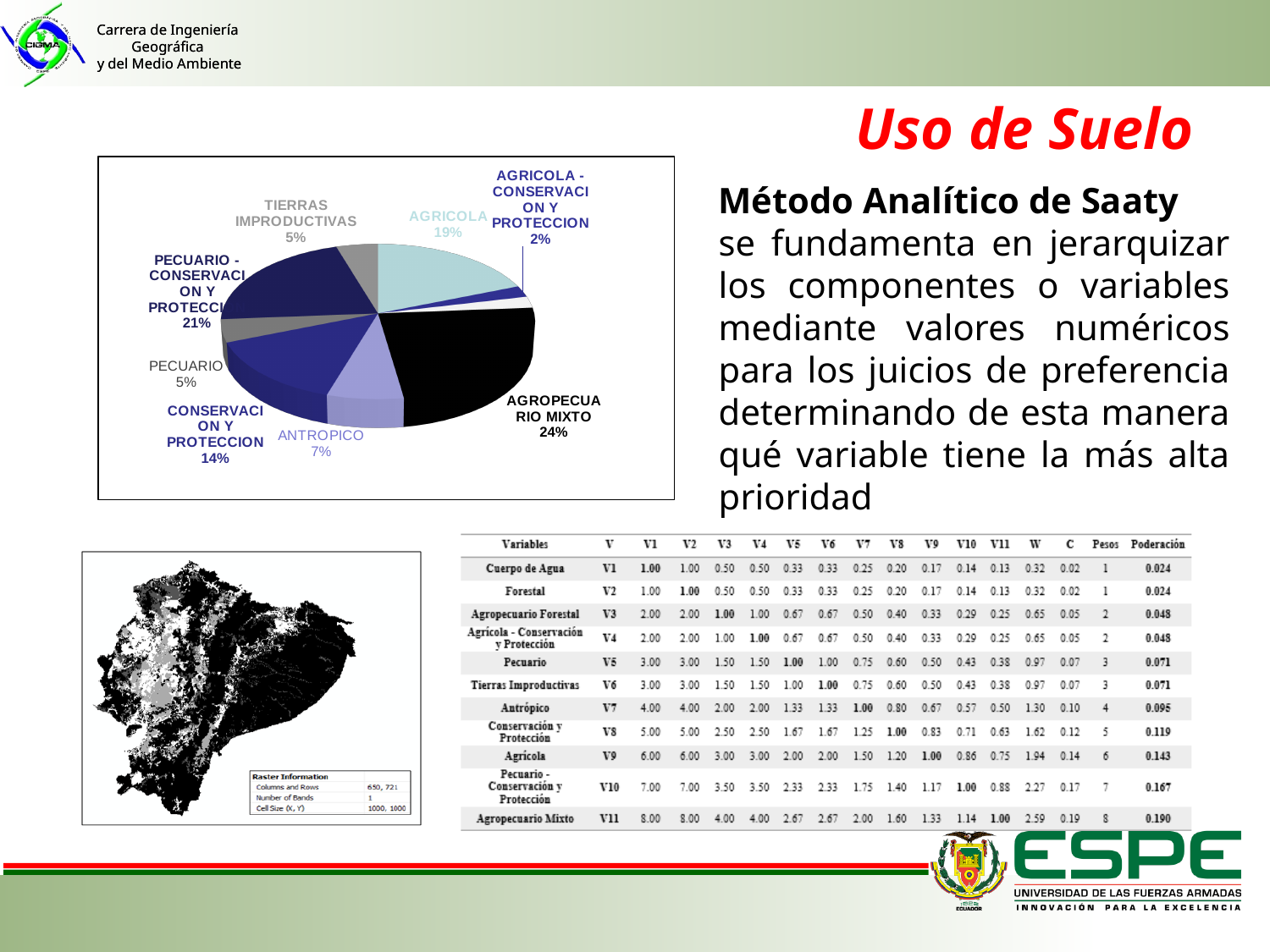
Which has a larger share, PECUARIO or ANTROPICO? ANTROPICO What percentage is shown for ANTROPICO? 7% Which labelled category has the smallest share of the pie? AGRICOLA - CONSERVACION Y PROTECCION What is the difference between the shares of AGROPECUARIO MIXTO and PECUARIO - CONSERVACION Y PROTECCION? 3% What percentage is shown for PECUARIO - CONSERVACION Y PROTECCION? 21% Which labelled category has the largest share of the pie? AGROPECUARIO MIXTO What percentage is shown for TIERRAS IMPRODUCTIVAS? 5% What is the value shown for AGRICOLA in the pie chart? 19% What percentage is shown for CONSERVACION Y PROTECCION? 14% What percentage is shown for AGRICOLA - CONSERVACION Y PROTECCION? 2% What type of chart is shown on the slide? pie chart What share of the pie does AGROPECUARIO MIXTO represent? 24%